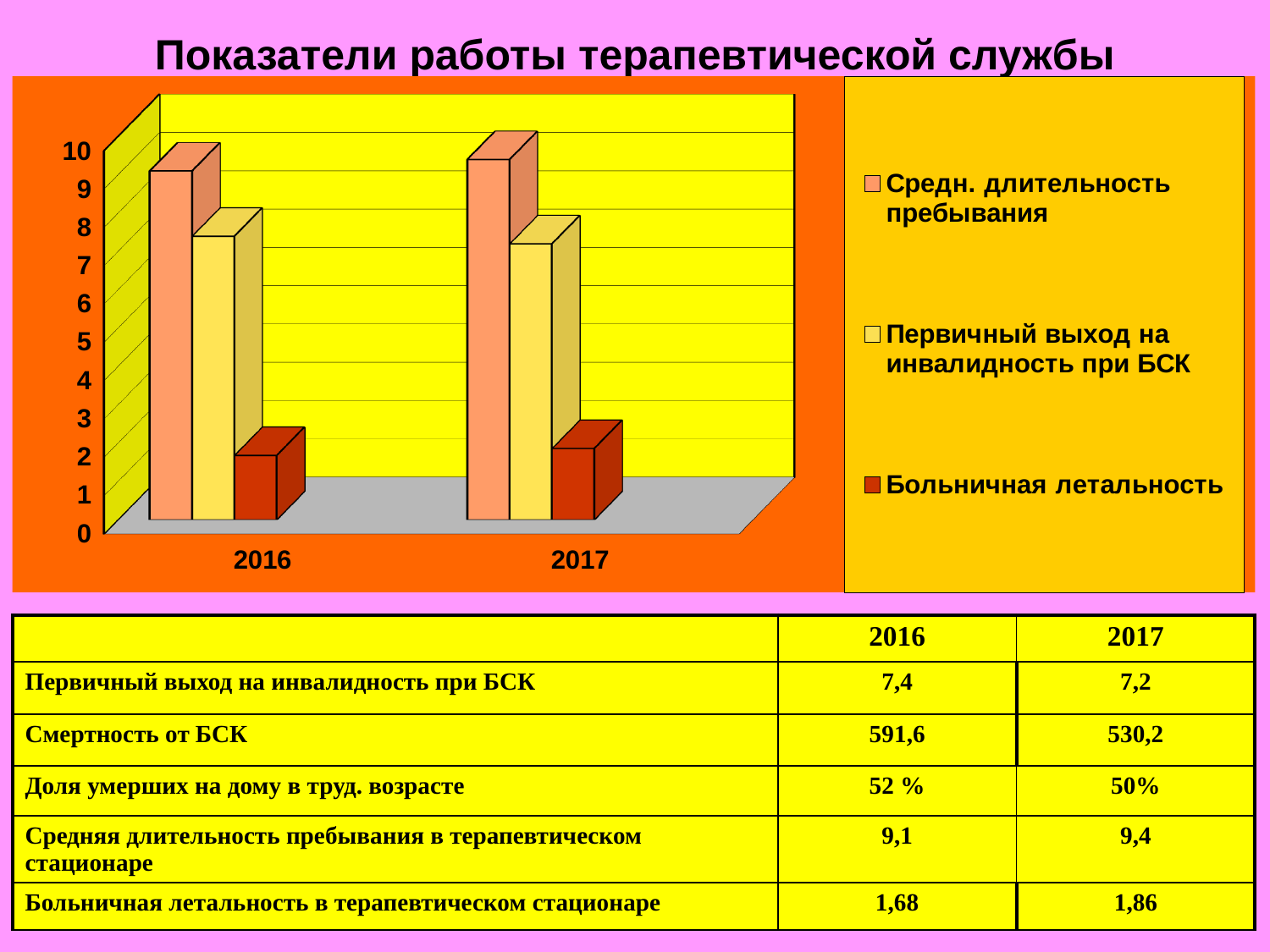
What kind of chart is shown on the slide? bar chart How many categories (years) are shown on the x axis of the chart? 2 Is the value for Средн. длительность пребывания in 2017 greater or less than 9? greater Does the value for Первичный выход на инвалидность при БСК rise or fall from 2016 to 2017? fall Which series has the tallest bars in the chart? Средн. длительность пребывания What is the title of the slide above the chart? Показатели работы терапевтической службы Which series has the shortest bars in the chart? Больничная летальность Is the value for Первичный выход на инвалидность при БСК in 2016 greater or less than 8? less According to the table, what is the value of Больничная летальность в терапевтическом стационаре in 2016? 1,68 How many series does the chart legend list? 3 According to the table, what is the value of Средняя длительность пребывания в терапевтическом стационаре in 2017? 9,4 Is the value for Больничная летальность in 2016 greater or less than 2? less